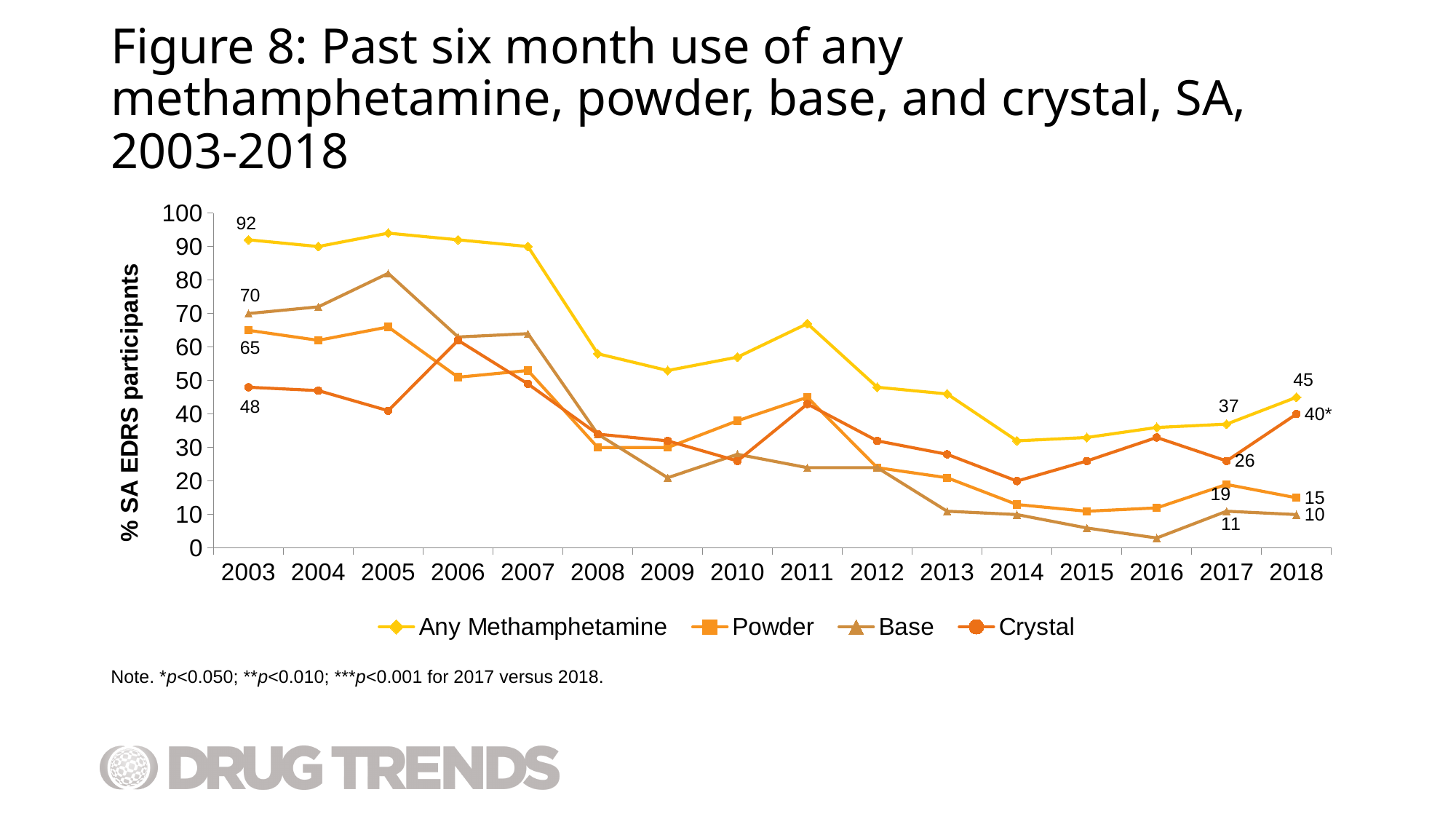
What was the value for Base in 2017? 11 Is the value for Base in 2016 greater or less than 10? less What kind of chart is shown on the slide? Line chart What was the value for Any Methamphetamine in 2003? 92 How many years are shown on the x axis? 16 In 2003, which was higher: Powder or Base? Base What was the value for Crystal in 2018? 40* What is the difference between the Crystal values in 2018 and 2017? 14 Which series had the highest value in 2018? Any Methamphetamine Which series had the lowest value in 2018? Base How many series does the legend list? 4 By how much did the Any Methamphetamine value change from 2017 to 2018? 8